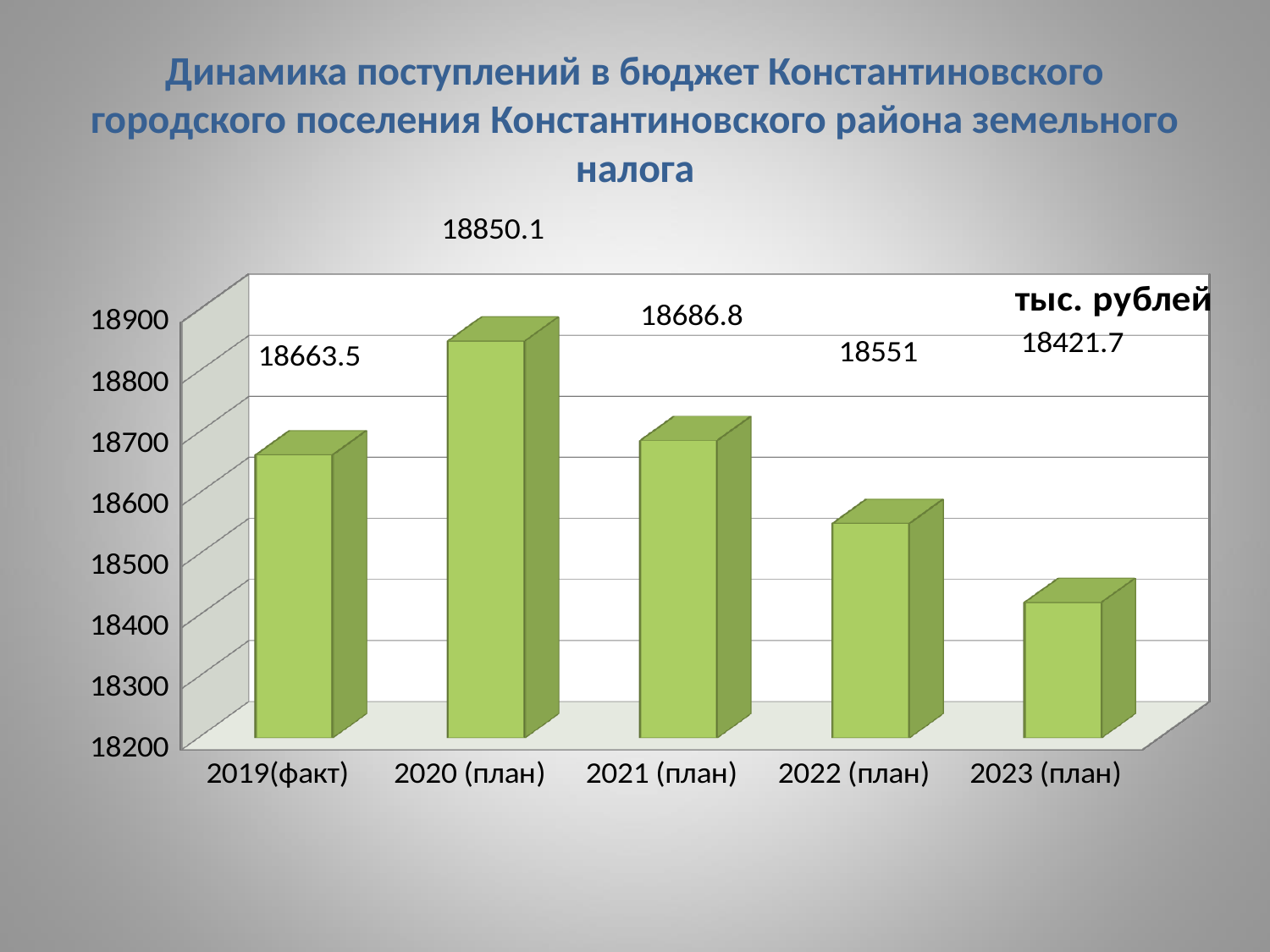
What is the difference between the values for 2021 (план) and 2022 (план)? 135.8 What is the value for 2023 (план)? 18421.7 Which category has the lowest value? 2023 (план) What unit is indicated in the top right corner of the chart? тыс. рублей Which is larger, the value for 2019(факт) or the value for 2022 (план)? 2019(факт) Which category has the highest value? 2020 (план) How many categories are shown on the x axis? 5 Is the value for 2022 (план) greater or less than 18600? less What is the value for 2019(факт)? 18663.5 What kind of chart is shown on the slide? bar chart What is the difference between the values for 2020 (план) and 2023 (план)? 428.4 What is the value for 2021 (план)? 18686.8